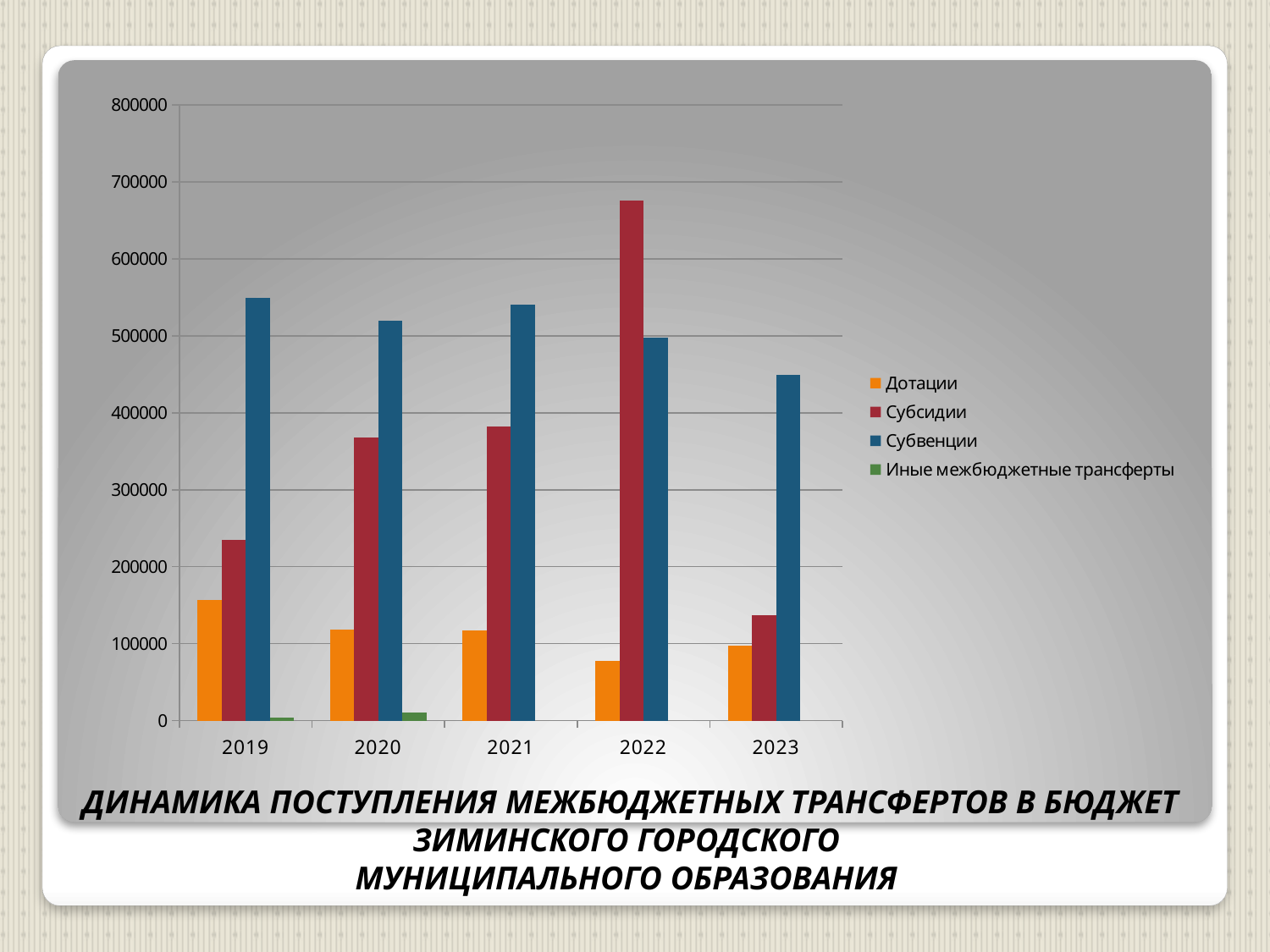
In which year is the value for Субвенции the lowest? 2023 Is the value for Субсидии in 2022 greater or less than 600000? greater How many years are shown on the x axis? 5 How many series does the legend list? 4 In 2019, which is larger: Дотации or Субсидии? Субсидии Is the value for Субвенции in 2019 greater or less than 500000? greater In 2022, which is larger: Субсидии or Субвенции? Субсидии Does the value for Дотации rise or fall from 2019 to 2022? fall In which year is the value for Дотации the highest? 2019 What kind of chart is shown on the slide? bar chart In which year is the value for Субсидии the highest? 2022 Is the value for Дотации in 2022 greater or less than 100000? less